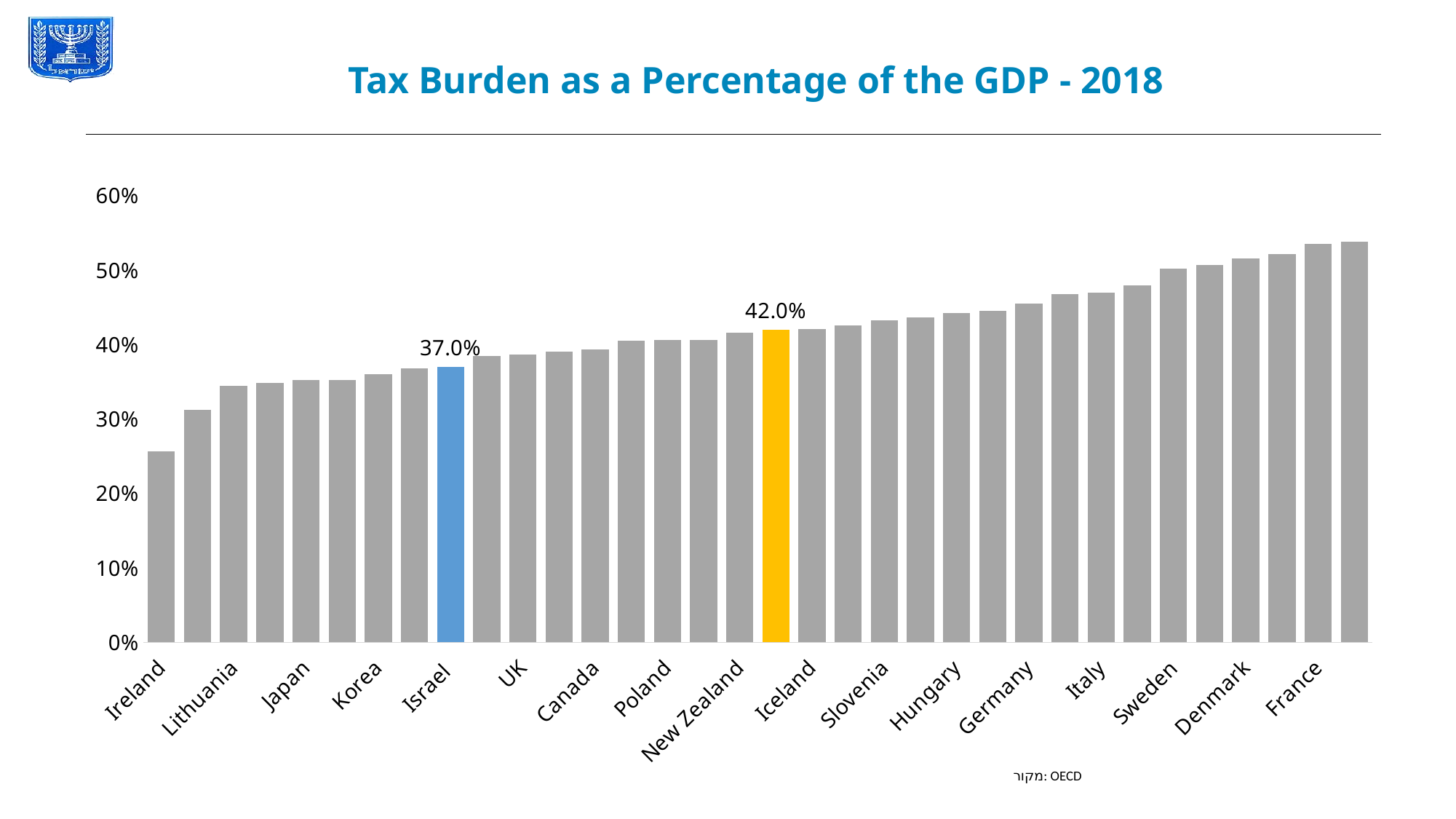
What is the tax burden as a percentage of GDP for Israel? 37.0% Which has a higher tax burden, Denmark or Japan? Denmark What kind of chart is shown on the slide? Bar chart Which labelled country has the lowest tax burden on the chart? Ireland Is the value for Sweden greater or less than 40%? greater Is the value for France greater or less than 50%? greater What colour is the bar for Israel? Blue Is the value for Ireland greater or less than 30%? less Which has a higher tax burden, Israel or Iceland? Iceland Do the values rise or fall moving from left to right along the x axis? Rise